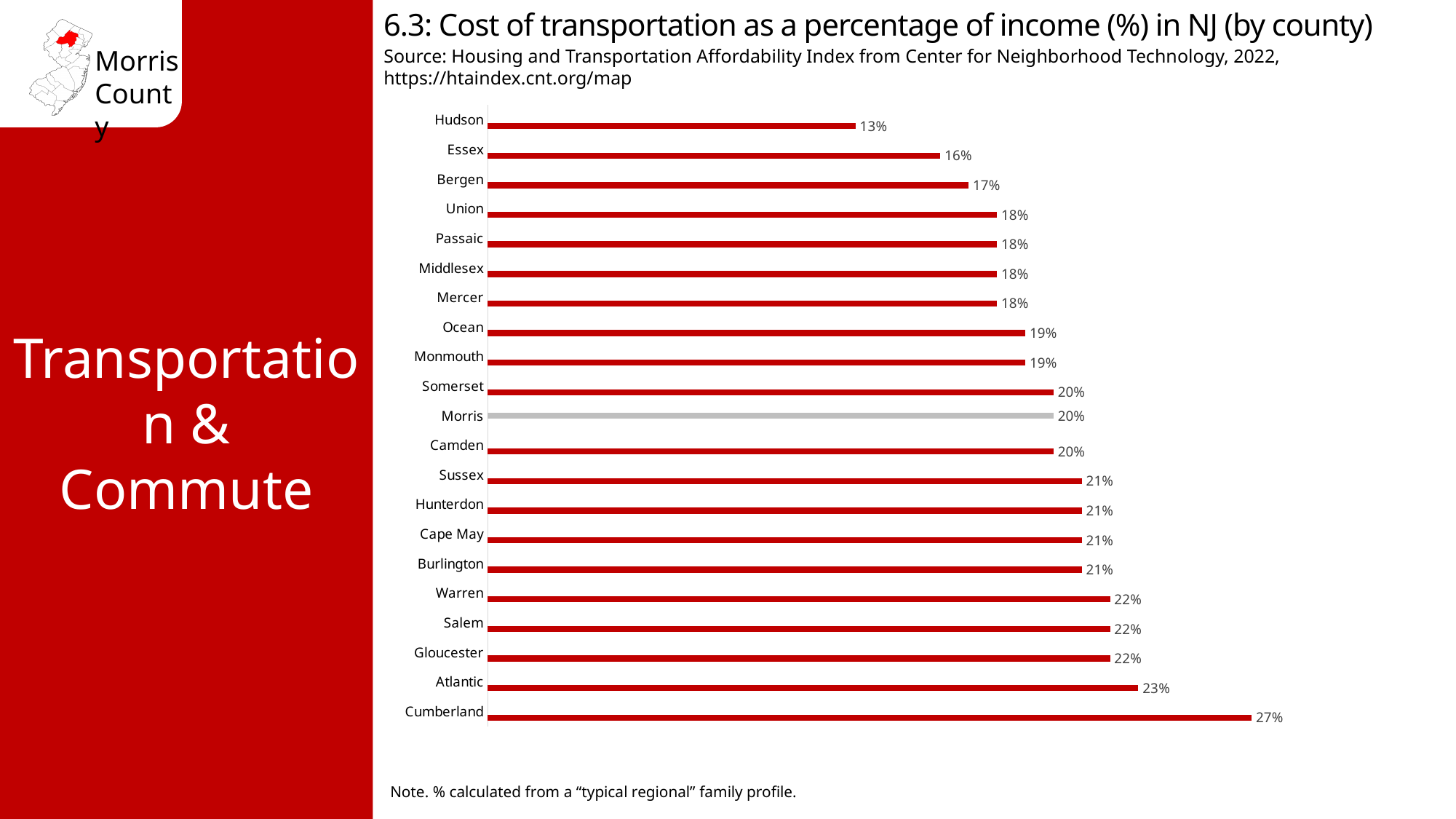
Which county has the lowest cost of transportation as a percentage of income? Hudson What is the value shown for Atlantic County? 23% Which county has the highest cost of transportation as a percentage of income? Cumberland Which has a higher value, Warren or Ocean? Warren Which county's bar is shown in grey rather than red? Morris What is the cost of transportation as a percentage of income for Morris County? 20% What is the value shown for Hudson County? 13% What kind of chart is shown on the slide? Bar chart How many counties are shown in the chart? 21 What is the source of the data shown in the chart? Housing and Transportation Affordability Index from Center for Neighborhood Technology, 2022 What is the difference between the values for Cumberland and Hudson? 14% What is the difference between the values for Essex and Bergen? 1%